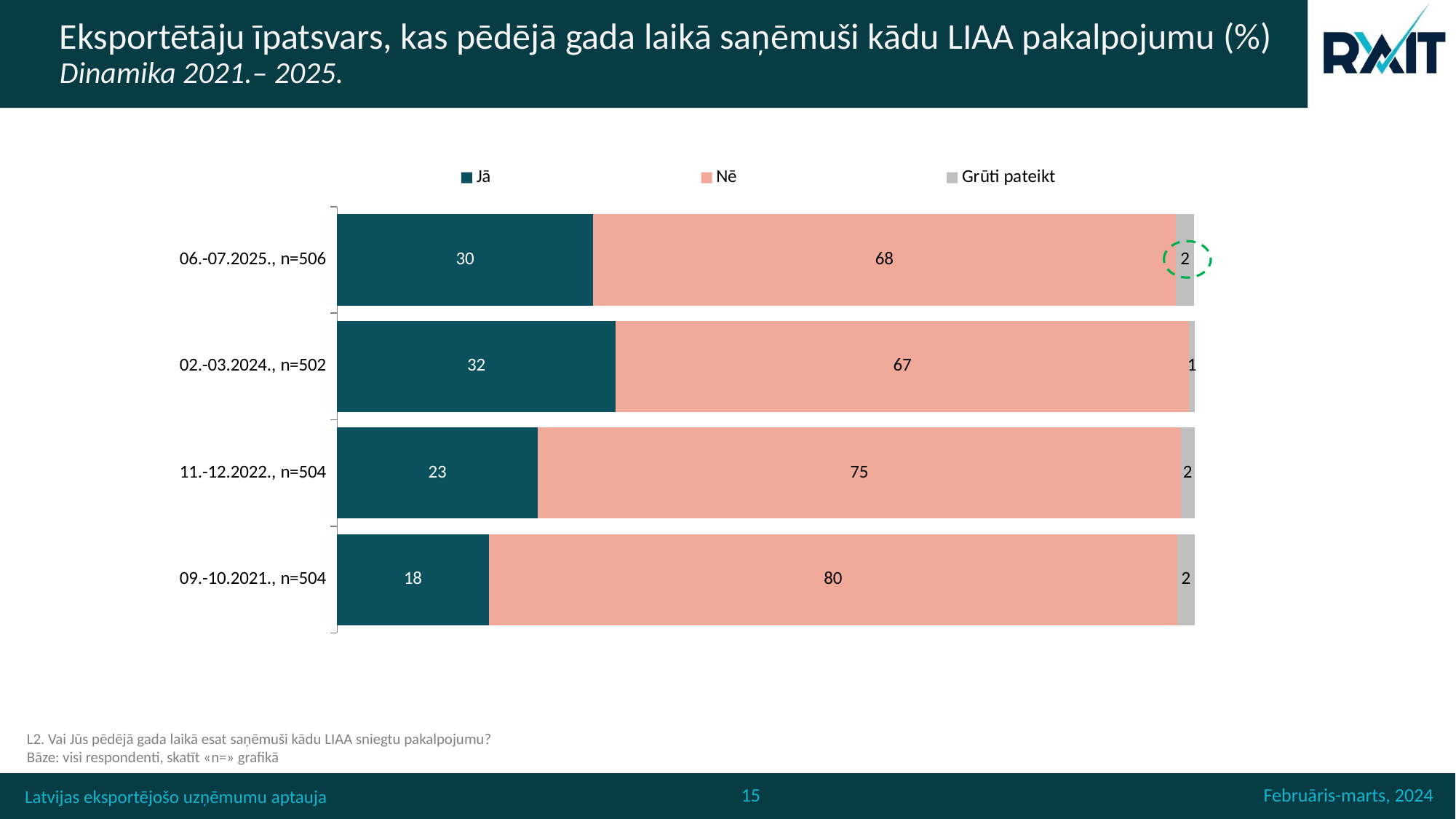
What is the value for "Nē" in the 09.-10.2021., n=504 bar? 80 What is the value for "Grūti pateikt" in the 02.-03.2024., n=502 bar? 1 Which survey wave has the lowest value for "Jā"? 09.-10.2021., n=504 What is the total of the stacked bar for 11.-12.2022., n=504? 100 Which survey wave has the highest value for "Jā"? 02.-03.2024., n=502 What kind of chart is shown on the slide? Stacked bar chart How many series does the legend list? 3 What is the difference between the "Nē" values for 09.-10.2021., n=504 and 06.-07.2025., n=506? 12 Which legend entry is shown in grey? Grūti pateikt What is the value for "Jā" in the 06.-07.2025., n=506 bar? 30 How many survey waves (bars) are shown in the chart? 4 Which is larger: the "Jā" value for 11.-12.2022., n=504 or for 06.-07.2025., n=506? 06.-07.2025., n=506